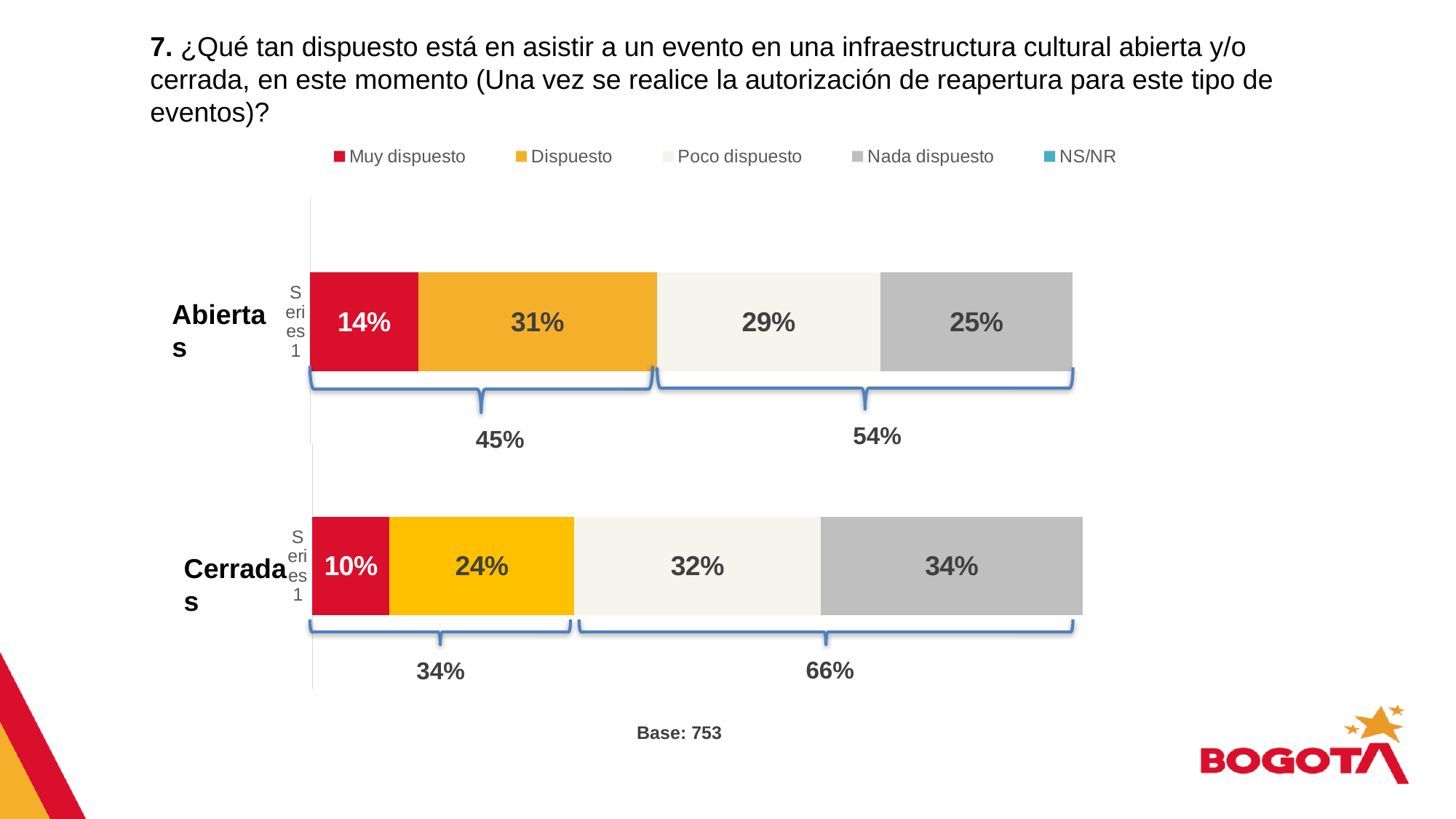
In the Abiertas chart, what combined percentage is shown under the bracket for Muy dispuesto and Dispuesto? 45% What is the difference between the Nada dispuesto values in the Cerradas chart and the Abiertas chart? 9% What kind of chart is used on this slide? Stacked bar chart In the Cerradas chart, what percentage is shown for Poco dispuesto? 32% In the Cerradas chart, which response category has the smallest share? Muy dispuesto In the Abiertas chart, what percentage is shown for Muy dispuesto? 14% In the Abiertas chart, which response category has the largest share? Dispuesto In the Abiertas chart, what percentage is shown for Dispuesto? 31% Which is larger: Muy dispuesto in the Abiertas chart or Muy dispuesto in the Cerradas chart? Abiertas How many series does the legend list? 5 In the Cerradas chart, what combined percentage is shown under the bracket for Poco dispuesto and Nada dispuesto? 66% In the Cerradas chart, what percentage is shown for Nada dispuesto? 34%